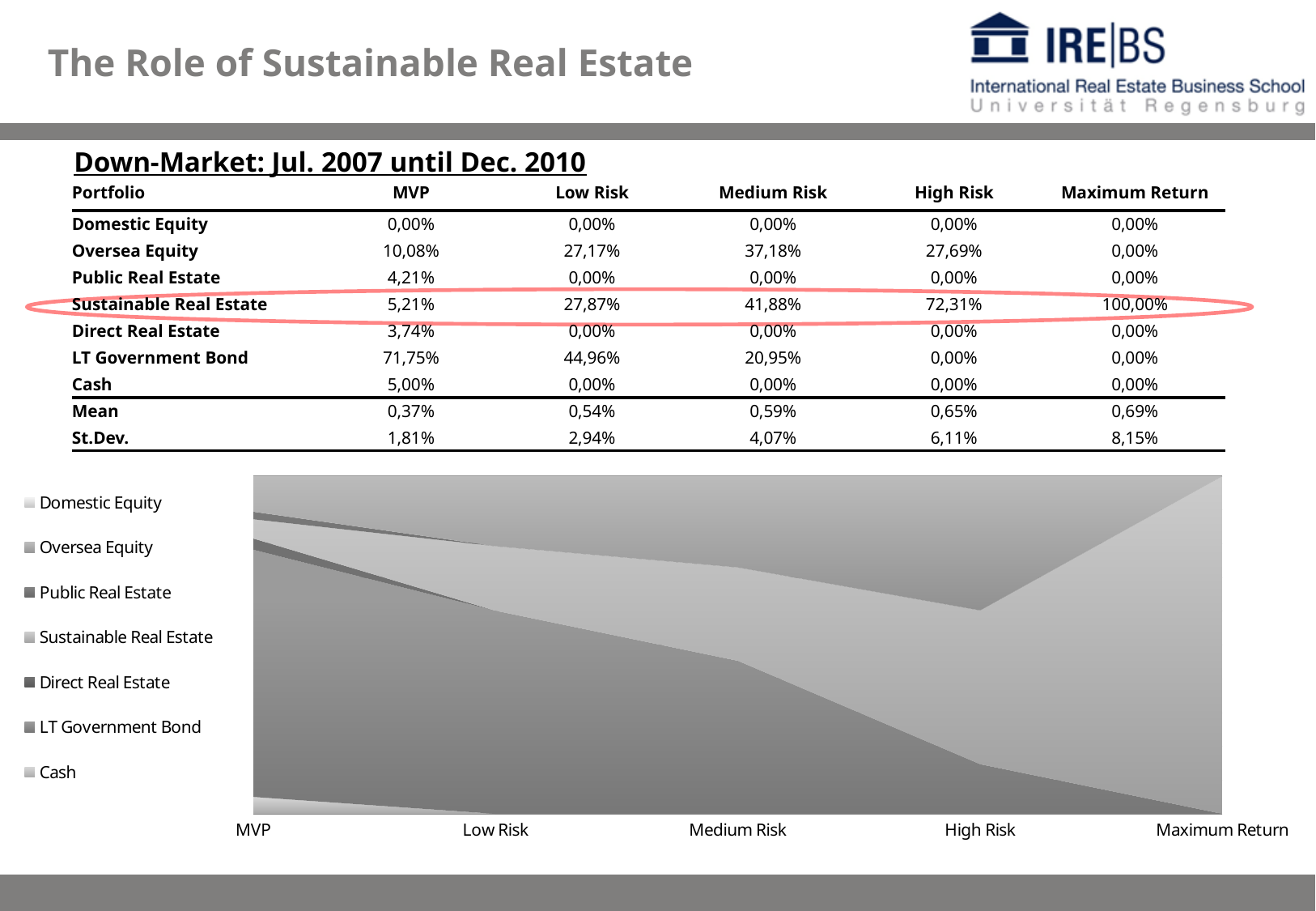
Which is larger for the Low Risk portfolio: LT Government Bond or Oversea Equity? LT Government Bond What is the difference between the Sustainable Real Estate share for High Risk and for Medium Risk? 30,43% Which portfolio has the highest Sustainable Real Estate share? Maximum Return Does the Sustainable Real Estate share rise or fall from MVP to Maximum Return along the x axis? Rise What is the value of Oversea Equity for the Medium Risk portfolio? 37,18% What is the value of Sustainable Real Estate for the Maximum Return portfolio? 100,00% Which portfolio has the lowest LT Government Bond share among MVP, Low Risk and Medium Risk? Medium Risk How many series does the chart's legend list? 7 What is the value of LT Government Bond for the MVP portfolio? 71,75% How many portfolio categories are shown along the x axis of the chart? 5 What kind of chart is shown at the bottom of the slide? Stacked area chart What is the title of the table above the chart? Down-Market: Jul. 2007 until Dec. 2010